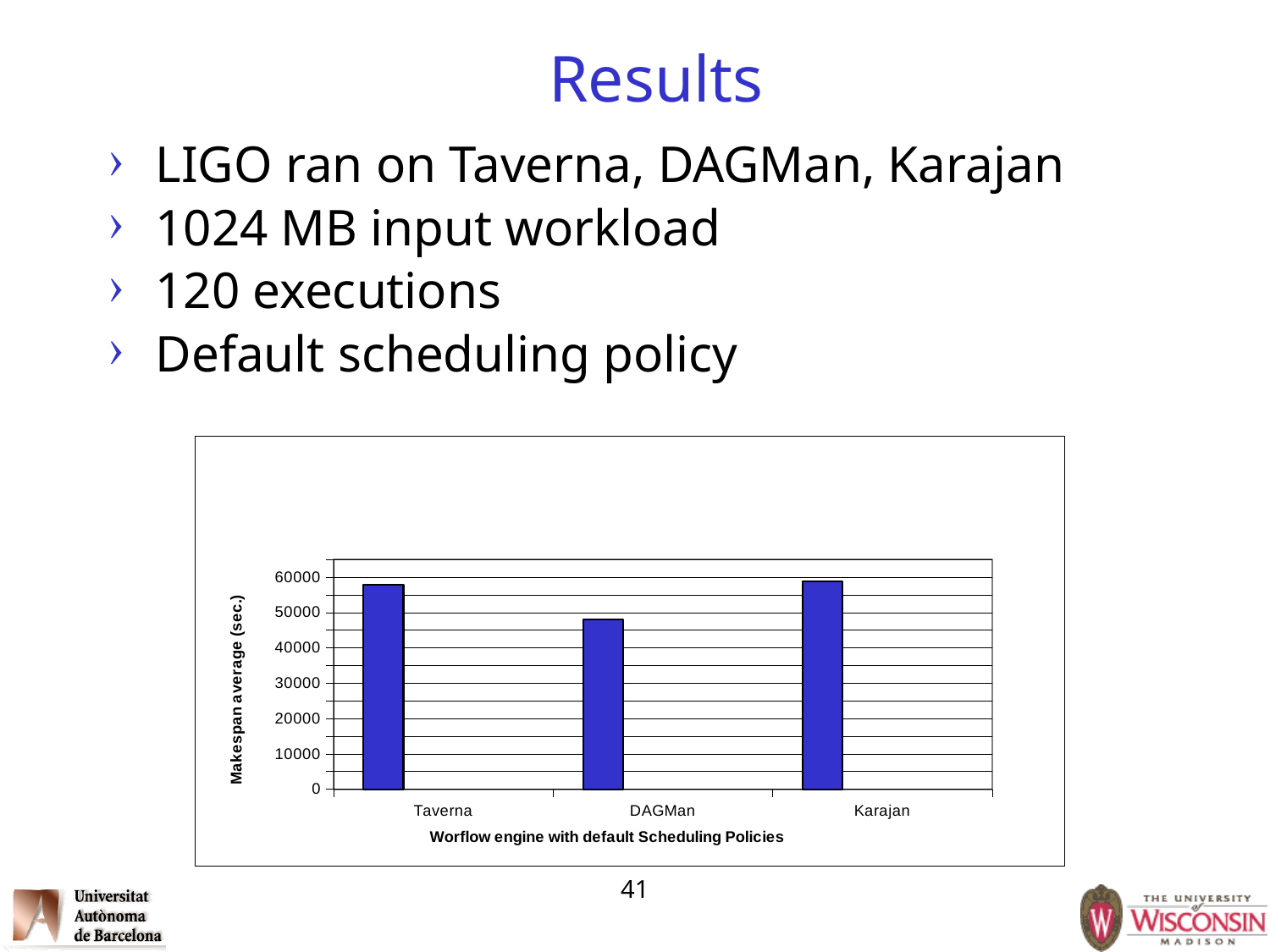
How many workflow engines are plotted on the chart? 3 Which has the larger makespan average, Taverna or DAGMan? Taverna What is the label of the vertical axis of the chart? Makespan average (sec.) Which workflow engine has the lowest makespan average? DAGMan Is the makespan average for Taverna greater or less than 50000? greater What is the label of the horizontal axis of the chart? Worflow engine with default Scheduling Policies Which has the larger makespan average, DAGMan or Karajan? Karajan Is the makespan average for DAGMan greater or less than 50000? less What kind of chart is shown on the slide? bar chart Is the makespan average for DAGMan greater or less than 40000? greater